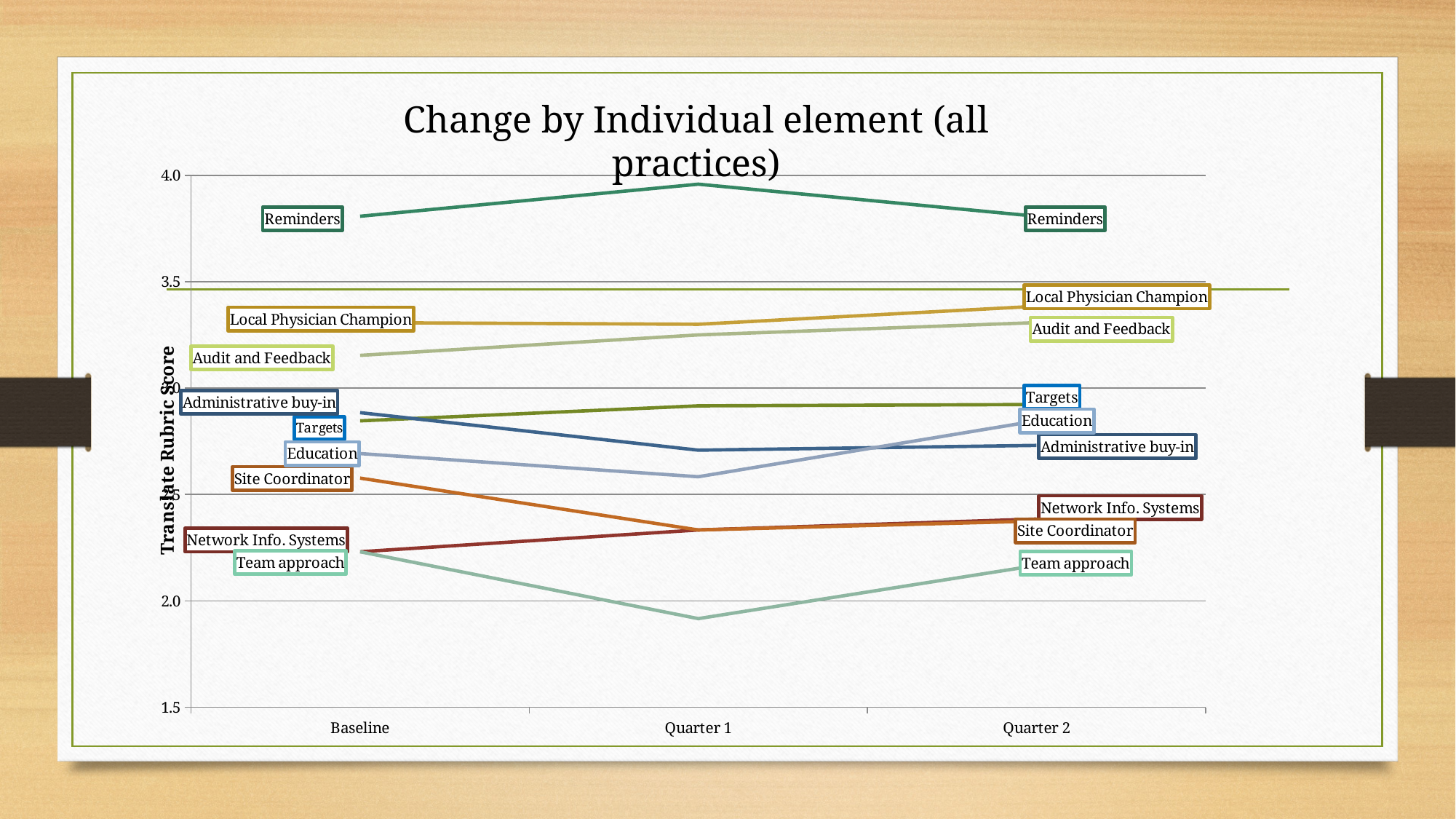
How many elements (lines) are plotted on the chart? 9 What is the title of the y axis? Translate Rubric Score Is the value for Site Coordinator at Baseline greater or less than 2.5? greater Is the value for Reminders at Quarter 1 greater or less than 3.5? greater At Quarter 2, which is higher: Reminders or Local Physician Champion? Reminders Is the value for Team approach at Quarter 1 greater or less than 2.0? less What kind of chart is shown on the slide? line chart Does the Team approach line rise or fall from Baseline to Quarter 1? fall Which element has the highest score at Baseline? Reminders Does the Audit and Feedback line rise or fall from Baseline to Quarter 2? rise How many time points are shown on the x axis? 3 Which element has the lowest score at Quarter 1? Team approach